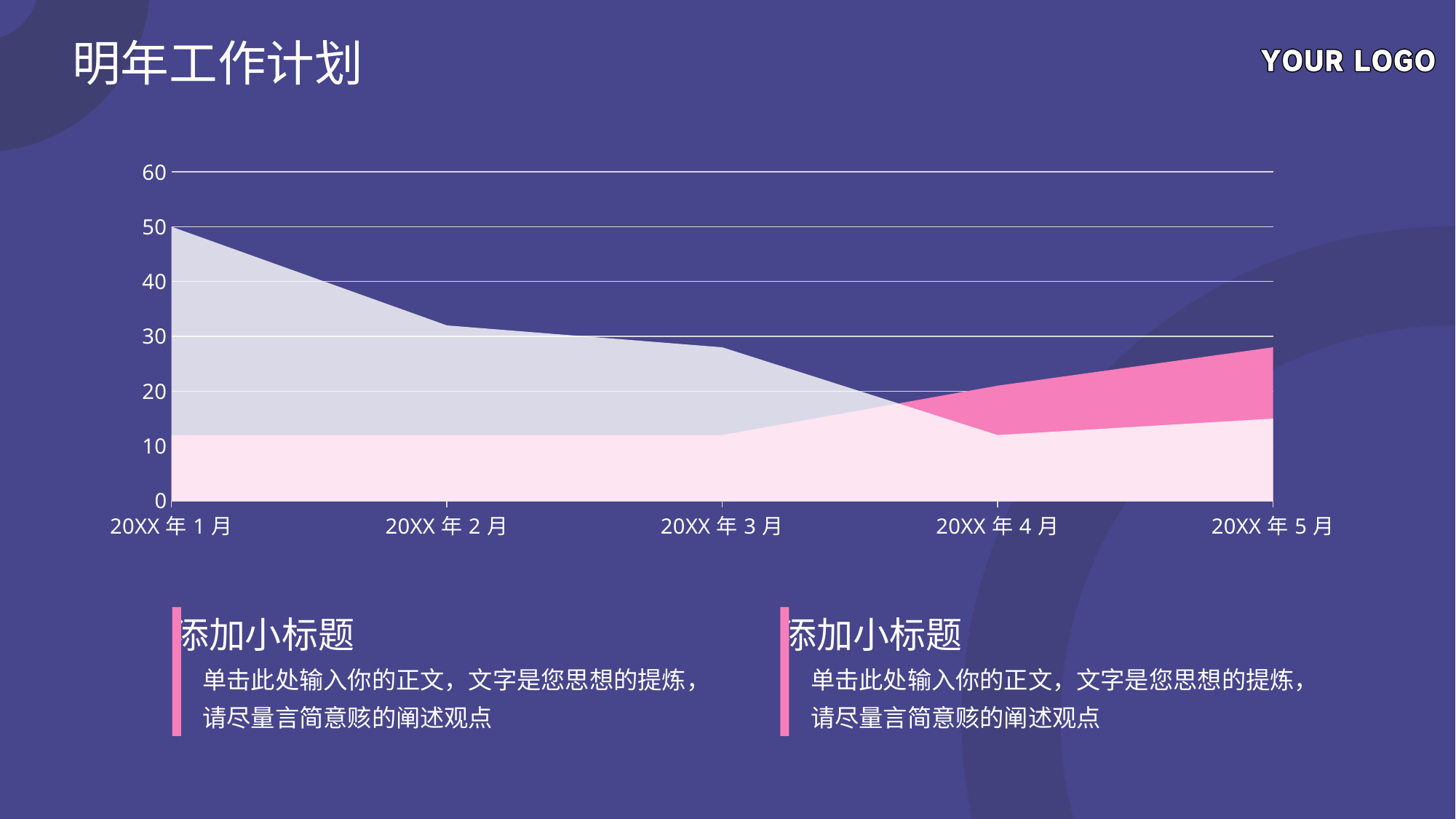
In which month does the pink series reach its highest value? 20XX 年 5 月 Is the value of the pink series at 20XX 年 1 月 greater or less than 20? less Is the value of the light grey series at 20XX 年 2 月 greater or less than 30? greater What is the value of the light grey series at 20XX 年 1 月? 50 Is the value of the pink series at 20XX 年 5 月 greater or less than 30? less How many months are shown along the x axis of the chart? 5 In which month does the light grey series reach its highest value? 20XX 年 1 月 What kind of chart is shown on the slide? Area chart Does the light grey series rise or fall from 20XX 年 1 月 to 20XX 年 4 月? Fall At 20XX 年 5 月, which series has the larger value, the pink series or the light grey series? Pink series